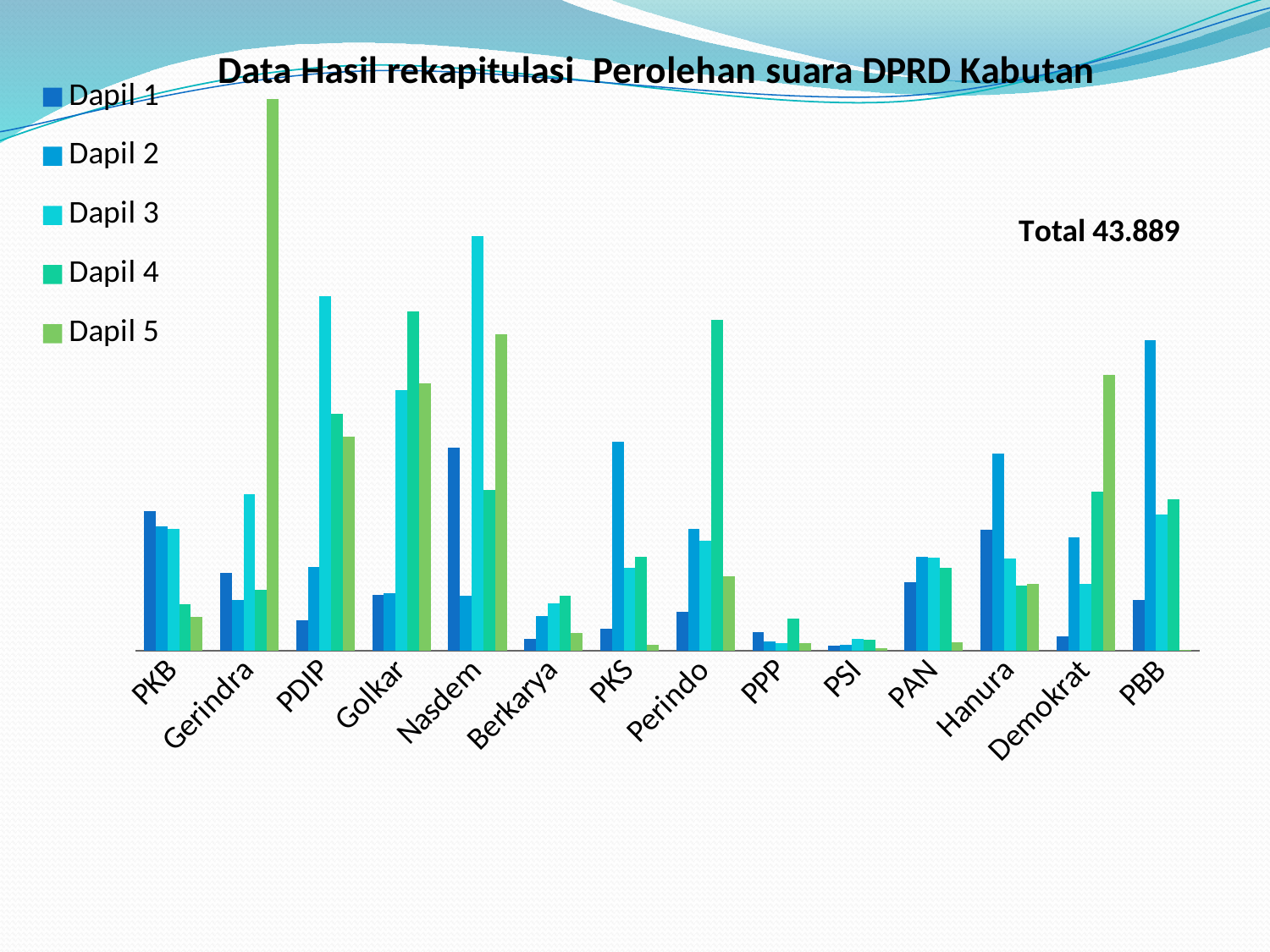
Which is larger: the Dapil 5 value for Demokrat or the Dapil 5 value for PAN? Demokrat What total is stated on the slide next to the chart? Total 43.889 How many series does the legend list? 5 For Gerindra, which Dapil series has the highest value? Dapil 5 Which party has the tallest bar in the chart? Gerindra For Nasdem, which Dapil series has the highest value? Dapil 3 How many parties (categories) are shown on the x axis? 14 For PKS, which Dapil series has the lowest value? Dapil 5 Which is larger: the Dapil 1 value for Nasdem or the Dapil 1 value for PKB? Nasdem What kind of chart is shown on the slide? bar chart Which party has the lowest values across all Dapil series? PSI